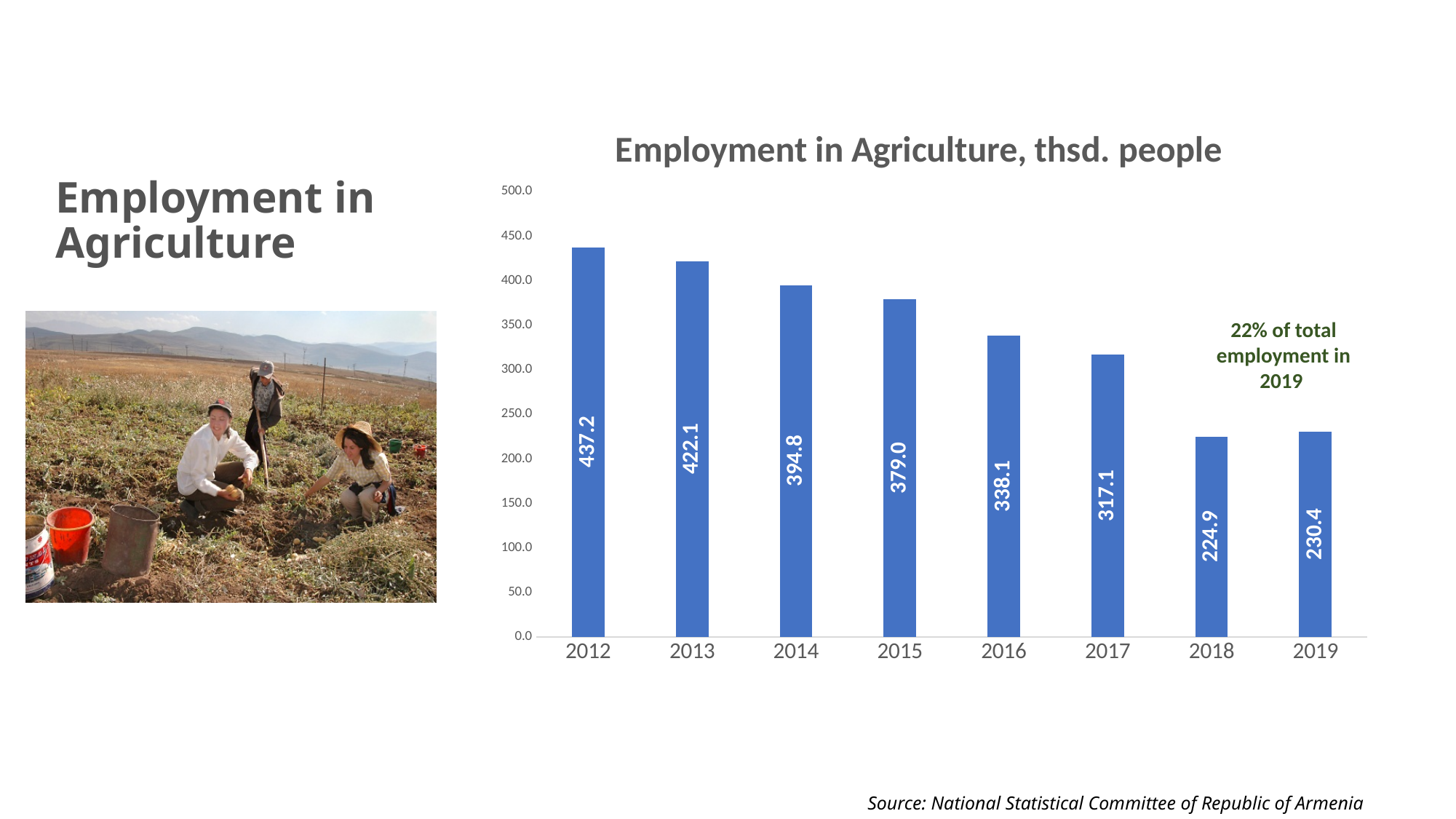
Is the value for 2015 greater or less than 350.0? greater What is the title of the chart? Employment in Agriculture, thsd. people Which year has the highest employment in agriculture? 2012 What is the value for 2016? 338.1 What is the difference between the values for 2017 and 2018? 92.2 How many years are shown on the x axis? 8 What is the value for 2019? 230.4 What kind of chart is shown on the slide? bar chart What is the difference between the values for 2012 and 2019? 206.8 Which is larger, the value for 2018 or the value for 2019? 2019 What is the value for 2012? 437.2 Which year has the lowest employment in agriculture? 2018